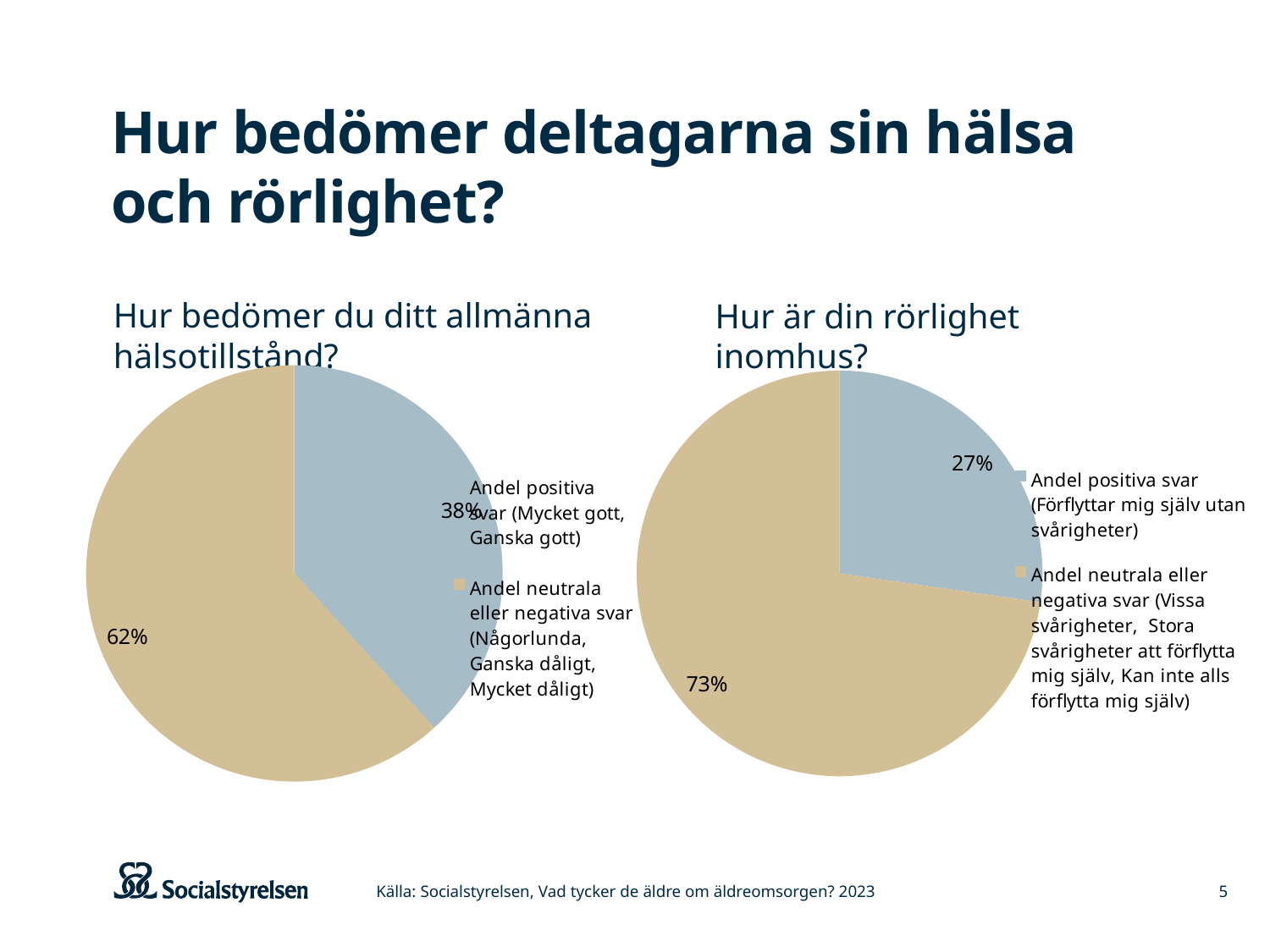
In the right chart (Hur är din rörlighet inomhus?), what share of answers are positive (Andel positiva svar)? 27% In the left chart (Hur bedömer du ditt allmänna hälsotillstånd?), what share of answers are neutral or negative (Andel neutrala eller negativa svar)? 62% In the left chart (Hur bedömer du ditt allmänna hälsotillstånd?), which category has the largest slice? Andel neutrala eller negativa svar In the right chart (Hur är din rörlighet inomhus?), which category has the smallest slice? Andel positiva svar In the left chart (Hur bedömer du ditt allmänna hälsotillstånd?), which colour represents Andel positiva svar? Blue (grey-blue) In the left chart (Hur bedömer du ditt allmänna hälsotillstånd?), what is the difference in percentage points between the neutral/negative share and the positive share? 24 percentage points What type of chart is used for the two charts on this slide? Pie chart In the left chart (Hur bedömer du ditt allmänna hälsotillstånd?), what share of answers are positive (Andel positiva svar)? 38% In the right chart (Hur är din rörlighet inomhus?), what is the difference in percentage points between the neutral/negative share and the positive share? 46 percentage points How many slices does the right chart (Hur är din rörlighet inomhus?) have? 2 In the right chart (Hur är din rörlighet inomhus?), what share of answers are neutral or negative (Andel neutrala eller negativa svar)? 73% Is the share of positive answers larger in the left chart (allmänna hälsotillstånd) or in the right chart (rörlighet inomhus)? Left chart (allmänna hälsotillstånd)